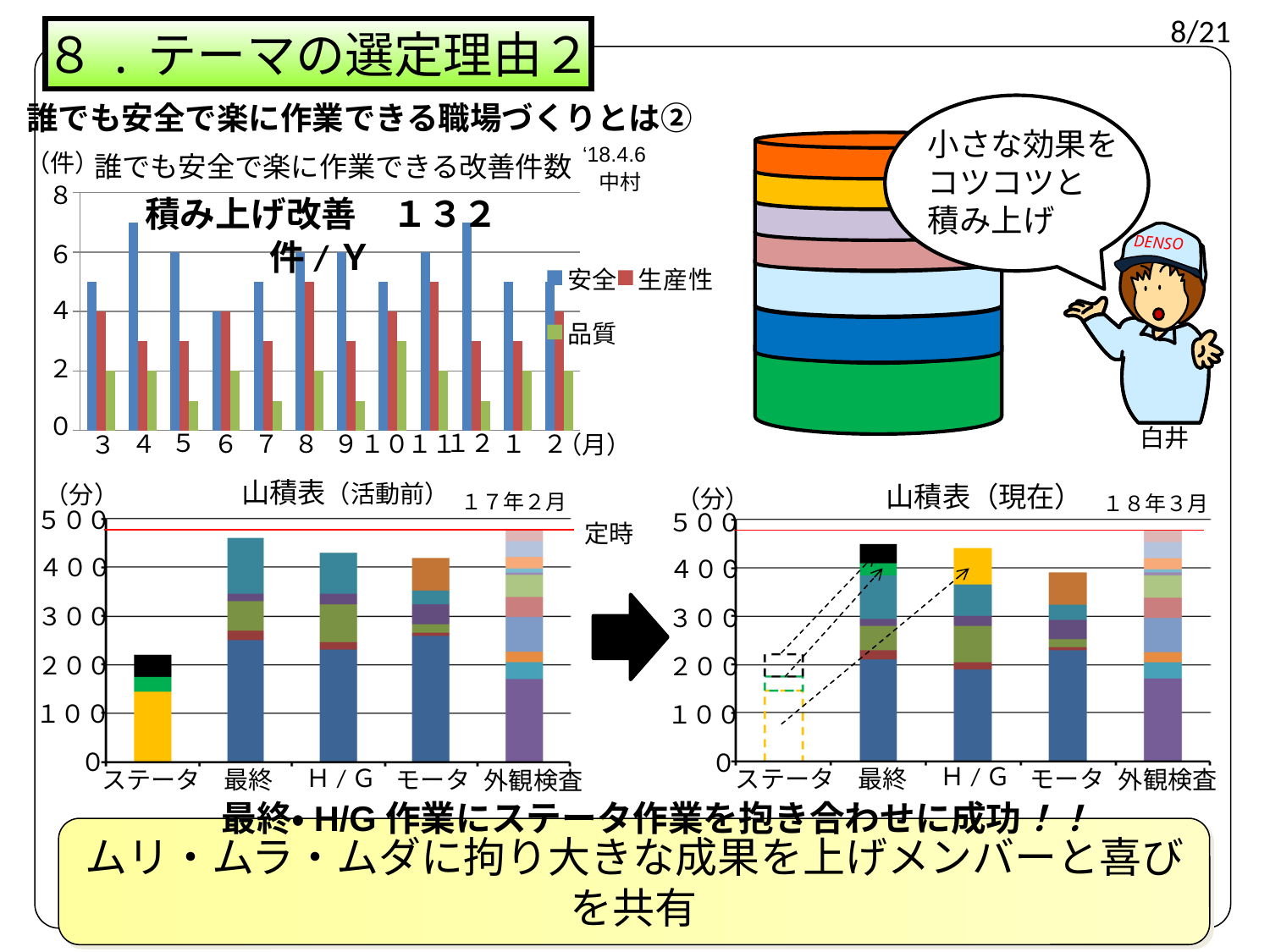
In the top-left chart 誰でも安全で楽に作業できる改善件数, is the 安全 value for month 4 greater or less than 6? greater In the bottom-left chart 山積表（活動前）, how many categories are on the x axis? 5 In the top-left chart 誰でも安全で楽に作業できる改善件数, how many months are shown on the x axis? 12 In the top-left chart 誰でも安全で楽に作業できる改善件数, how many series does the legend list? 3 In the top-left chart 誰でも安全で楽に作業できる改善件数, what are the legend entries? 安全, 生産性, 品質 What kind of chart is the top-left chart 誰でも安全で楽に作業できる改善件数? bar chart In the top-left chart 誰でも安全で楽に作業できる改善件数, what is the 安全 value for month 6? 4 In the bottom-left chart 山積表（活動前）, which category has the lowest stacked total? ステータ In the top-left chart 誰でも安全で楽に作業できる改善件数, which is larger for month 8, 安全 or 品質? 安全 In the bottom-left chart 山積表（活動前）, is the stacked total for 最終 greater or less than 400? greater In the bottom-left chart 山積表（活動前）, what is the label of the red horizontal line? 定時